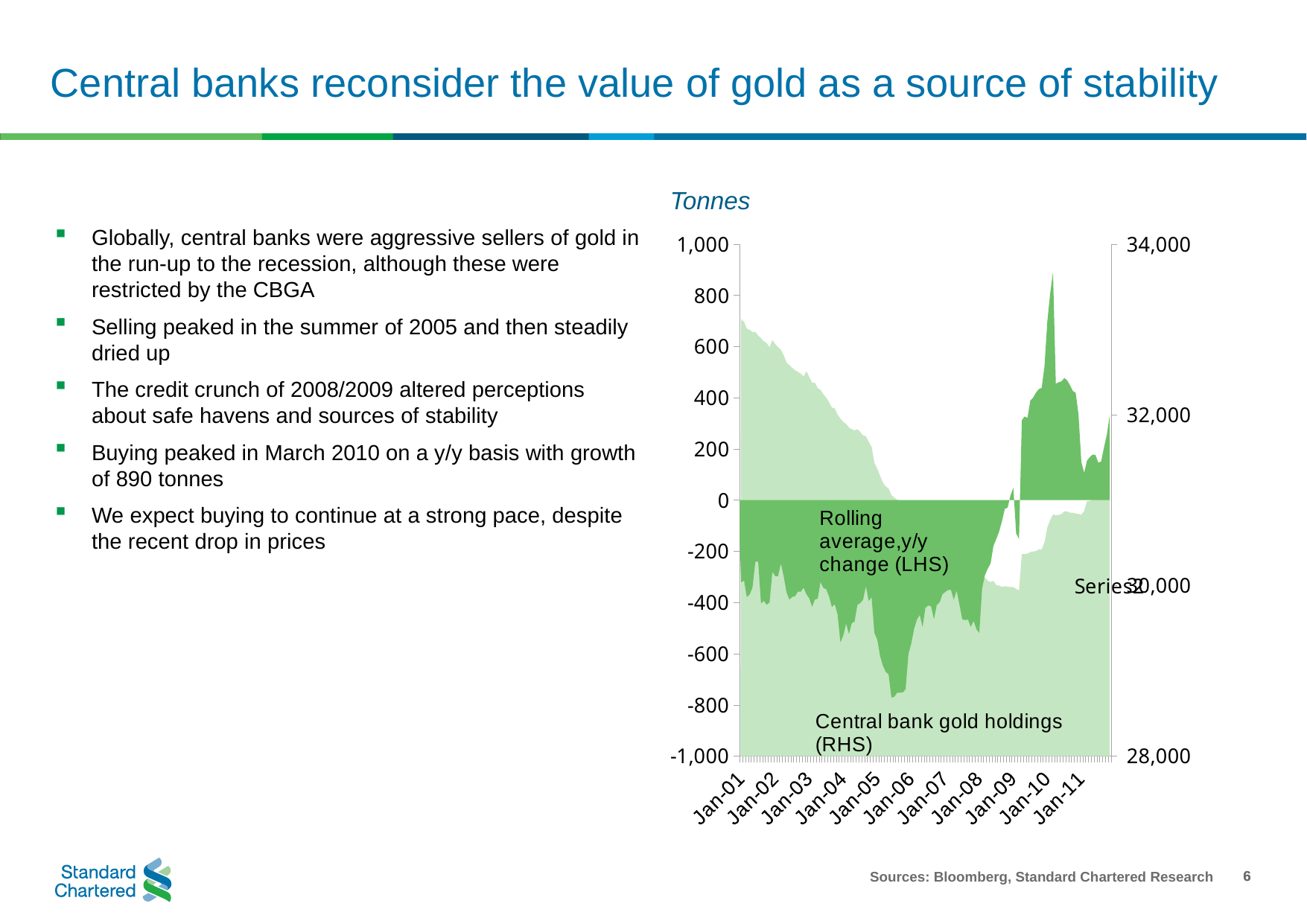
Is the rolling average y/y change (LHS) at Jan-01 greater or less than 0? less Do central bank gold holdings (RHS) rise or fall between Jan-01 and Jan-09? fall Which series is plotted against the right-hand axis (RHS)? Central bank gold holdings Around which year label does the rolling average y/y change (LHS) reach its lowest value? Jan-06 What is the title shown above the chart? Tonnes Around which year label does the rolling average y/y change (LHS) reach its highest value? Jan-10 Is the peak value of the rolling average y/y change (LHS) around Jan-10 greater or less than 800? greater How many year labels (Jan-01 to Jan-11) are shown on the x axis? 11 What kind of chart is shown on the slide? Area chart Does the rolling average y/y change (LHS) rise or fall between Jan-06 and Jan-10? rise Is the central bank gold holdings (RHS) value at Jan-01 greater or less than 32,000? greater